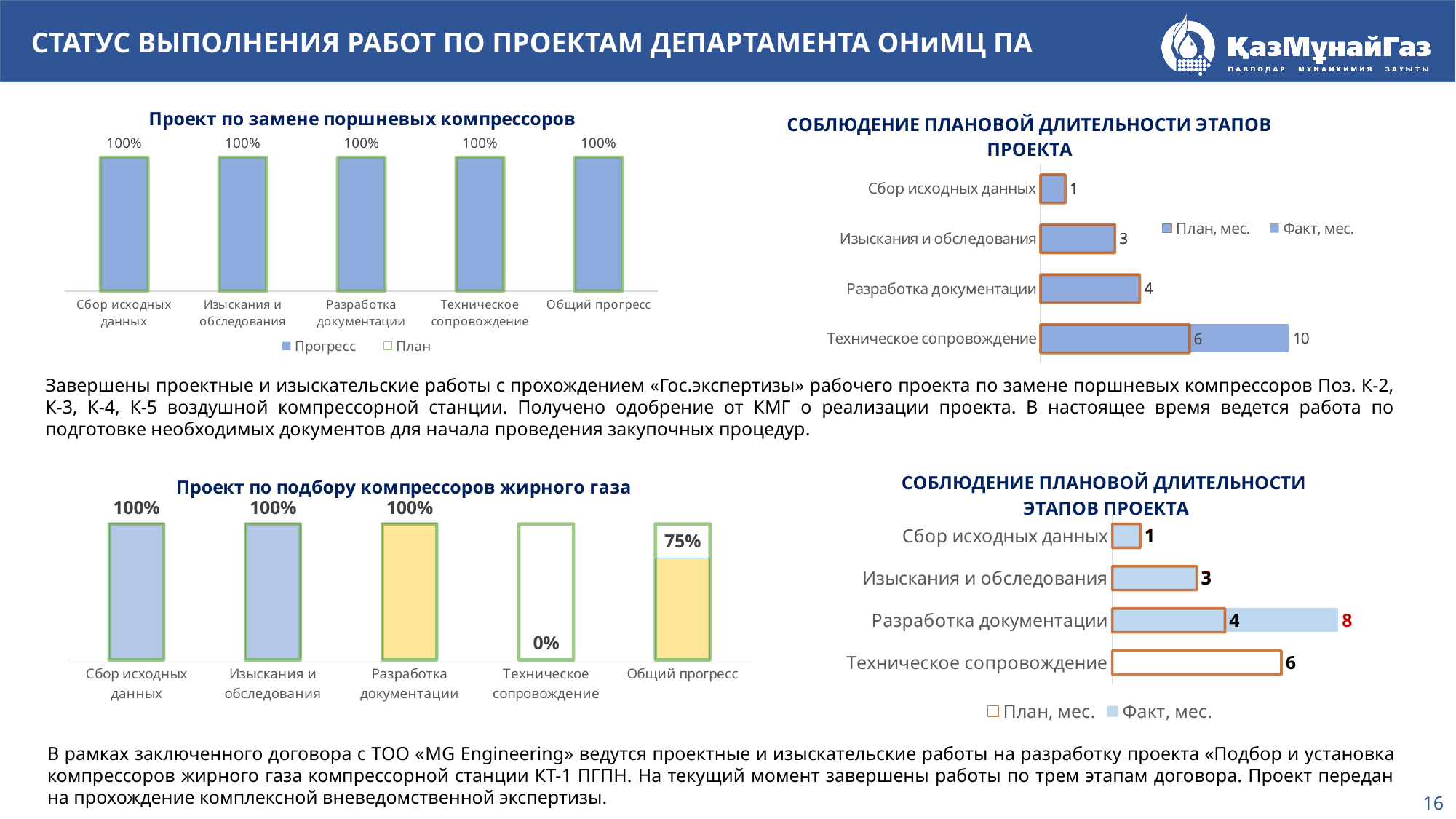
How many series does the legend of the bottom-right chart list? 2 In the top-right chart (СОБЛЮДЕНИЕ ПЛАНОВОЙ ДЛИТЕЛЬНОСТИ ЭТАПОВ ПРОЕКТА), what is the Факт, мес. value for Техническое сопровождение? 10 What kind of chart is the top-left chart 'Проект по замене поршневых компрессоров'? Bar chart How many categories are shown in the top-left chart 'Проект по замене поршневых компрессоров'? 5 In the bottom-left chart 'Проект по подбору компрессоров жирного газа', which category has the lowest value? Техническое сопровождение In the bottom-right chart, what is the difference between the Факт and План values for Разработка документации? 4 In the top-left chart 'Проект по замене поршневых компрессоров', what is the value for Общий прогресс? 100% In the top-right chart (СОБЛЮДЕНИЕ ПЛАНОВОЙ ДЛИТЕЛЬНОСТИ ЭТАПОВ ПРОЕКТА), what is the План, мес. value for Техническое сопровождение? 6 In the top-right chart, which stage has the lowest План, мес. value? Сбор исходных данных In the bottom-left chart 'Проект по подбору компрессоров жирного газа', what is the value for Общий прогресс? 75% In the bottom-right chart (СОБЛЮДЕНИЕ ПЛАНОВОЙ ДЛИТЕЛЬНОСТИ ЭТАПОВ ПРОЕКТА), what is the Факт, мес. value for Разработка документации? 8 In the top-right chart, by how many months does the Факт value for Техническое сопровождение exceed the План value? 4